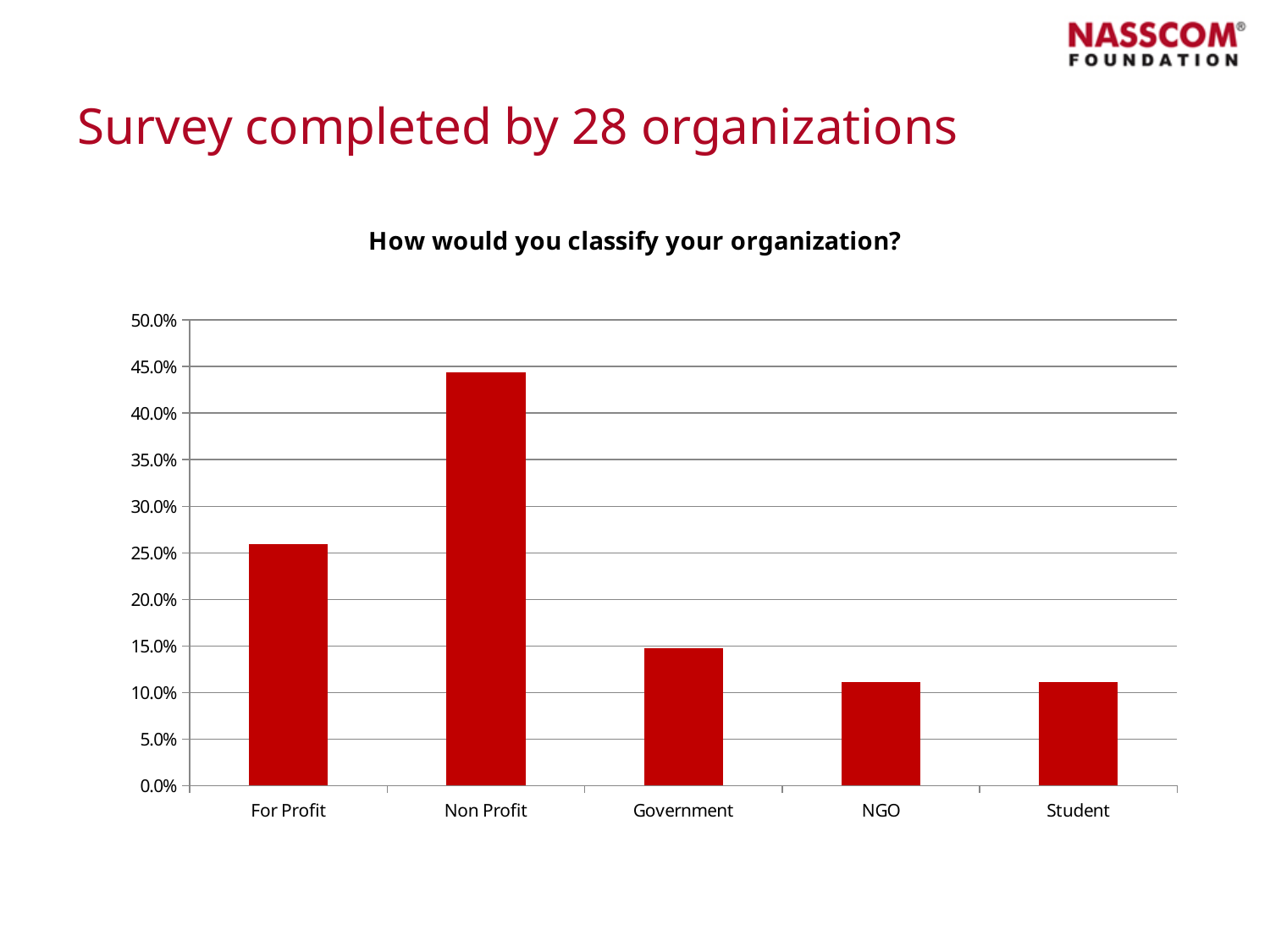
Is the value for Student greater or less than 15.0%? less Is the value for For Profit greater or less than 30.0%? less What is the title of the chart? How would you classify your organization? Which is larger, the value for For Profit or the value for Government? For Profit How many organization categories are shown on the x axis? 5 Is the value for NGO greater or less than 15.0%? less What colour are the bars in the chart? red Which organization category has the highest value? Non Profit What type of chart is shown on the slide? bar chart Which is larger, the value for Government or the value for NGO? Government